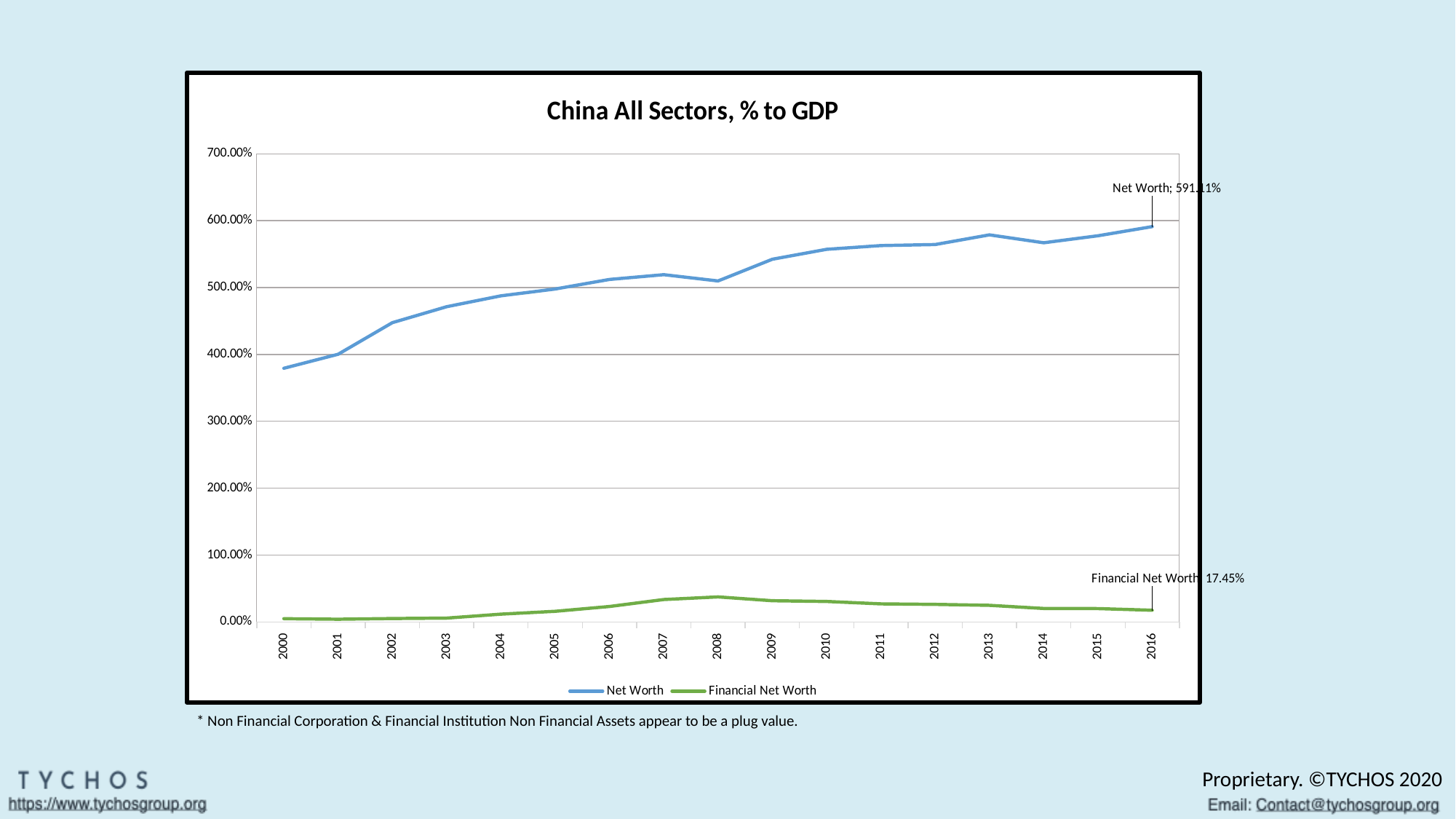
Does the Net Worth line generally rise or fall from 2000 to 2016? rise Is the Net Worth value for 2008 greater or less than 500%? greater How many years are plotted on the x axis? 17 What is the title of the chart? China All Sectors, % to GDP Is the Net Worth value for 2000 greater or less than 400%? less In which year is Net Worth at its lowest? 2000 How many series does the legend list? 2 In 2016, which is larger: Net Worth or Financial Net Worth? Net Worth What kind of chart is shown on the slide? line chart What is the Net Worth value for 2016? 591.11% What is the difference between Net Worth and Financial Net Worth in 2016? 573.66% What is the Financial Net Worth value for 2016? 17.45%